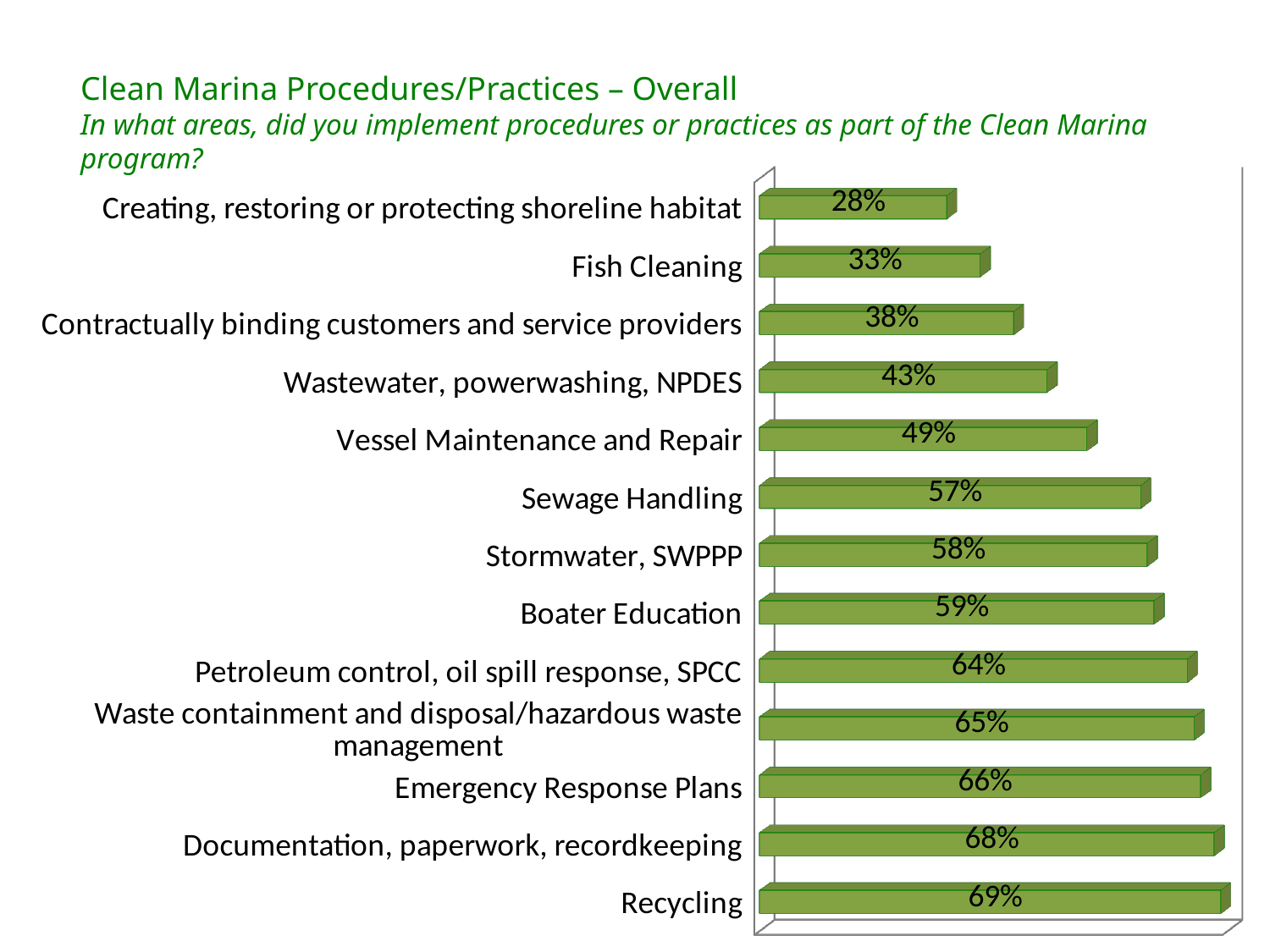
What kind of chart is shown on the slide? Bar chart Which category has the highest percentage? Recycling What percentage is shown for Waste containment and disposal/hazardous waste management? 65% What is the title of the chart? Clean Marina Procedures/Practices – Overall How many categories are shown in the chart? 13 Which is larger, the percentage for Boater Education or the percentage for Fish Cleaning? Boater Education Which category has the lowest percentage? Creating, restoring or protecting shoreline habitat What is the difference between the percentages for Vessel Maintenance and Repair and Wastewater, powerwashing, NPDES? 6% What percentage is shown for Sewage Handling? 57% What is the difference between the percentages for Recycling and Creating, restoring or protecting shoreline habitat? 41% What percentage is shown for Fish Cleaning? 33% What percentage is shown for Recycling? 69%